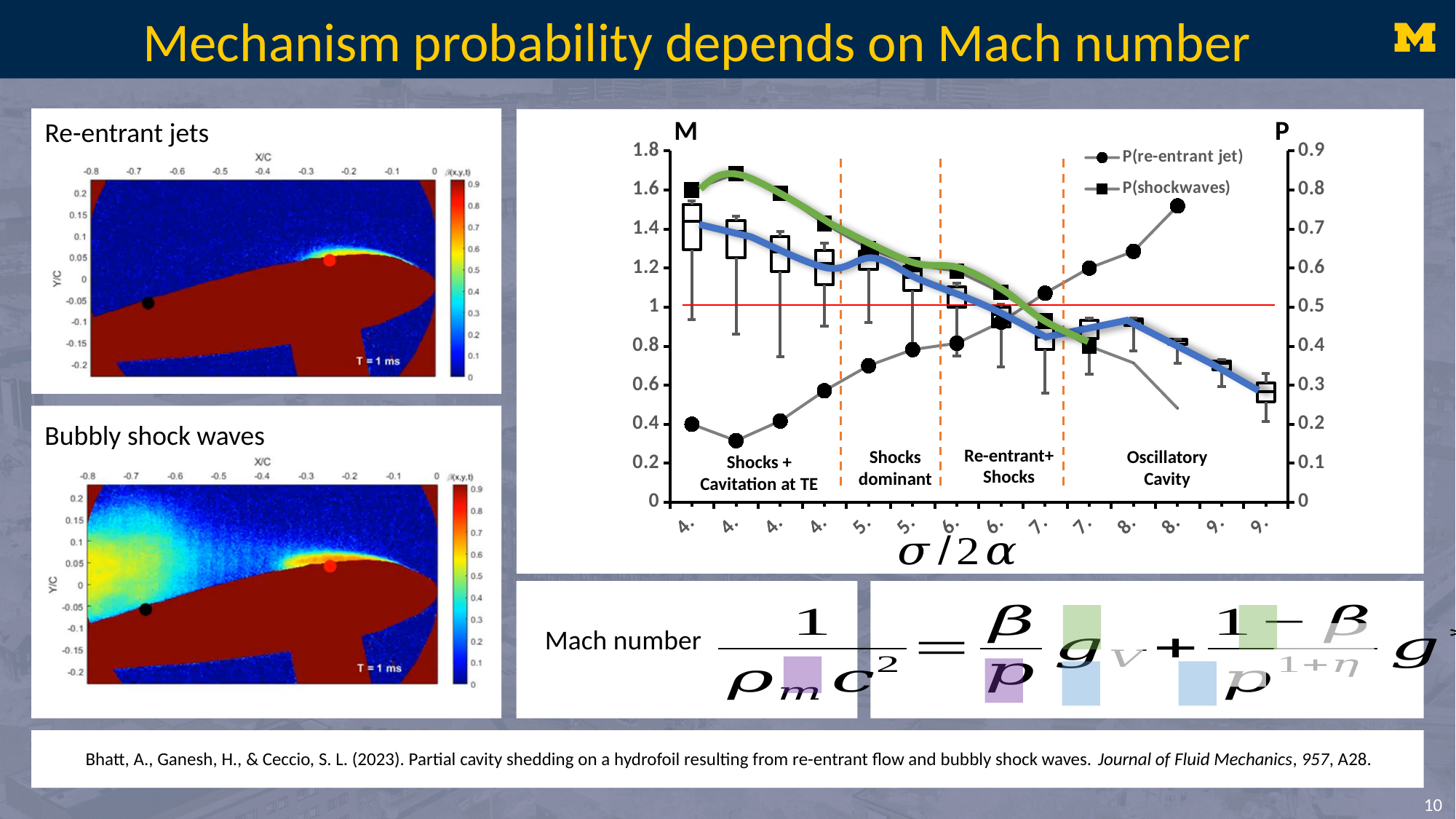
What are the two series named in the chart legend? P(re-entrant jet) and P(shockwaves) Does the P(shockwaves) series rise or fall as σ/2α increases along the x axis? Falls What is the label on the x axis of the chart? σ/2α On the right-hand P axis, is the last P(shockwaves) value greater or less than 0.4? less On the right-hand P axis, is the first P(shockwaves) value greater or less than 0.7? greater Does the P(re-entrant jet) series rise or fall as σ/2α increases along the x axis? Rises What kind of chart is used to plot P(re-entrant jet) and P(shockwaves)? Line chart How many series does the legend of the chart list? 2 How many labelled regimes (separated by dashed vertical lines) are marked along the bottom of the chart? 4 At the leftmost x position, which series has the larger value: P(shockwaves) or P(re-entrant jet)? P(shockwaves) At the rightmost plotted point of P(re-entrant jet), which series is larger: P(re-entrant jet) or P(shockwaves)? P(re-entrant jet) On the right-hand P axis, is the first P(re-entrant jet) value greater or less than 0.3? less